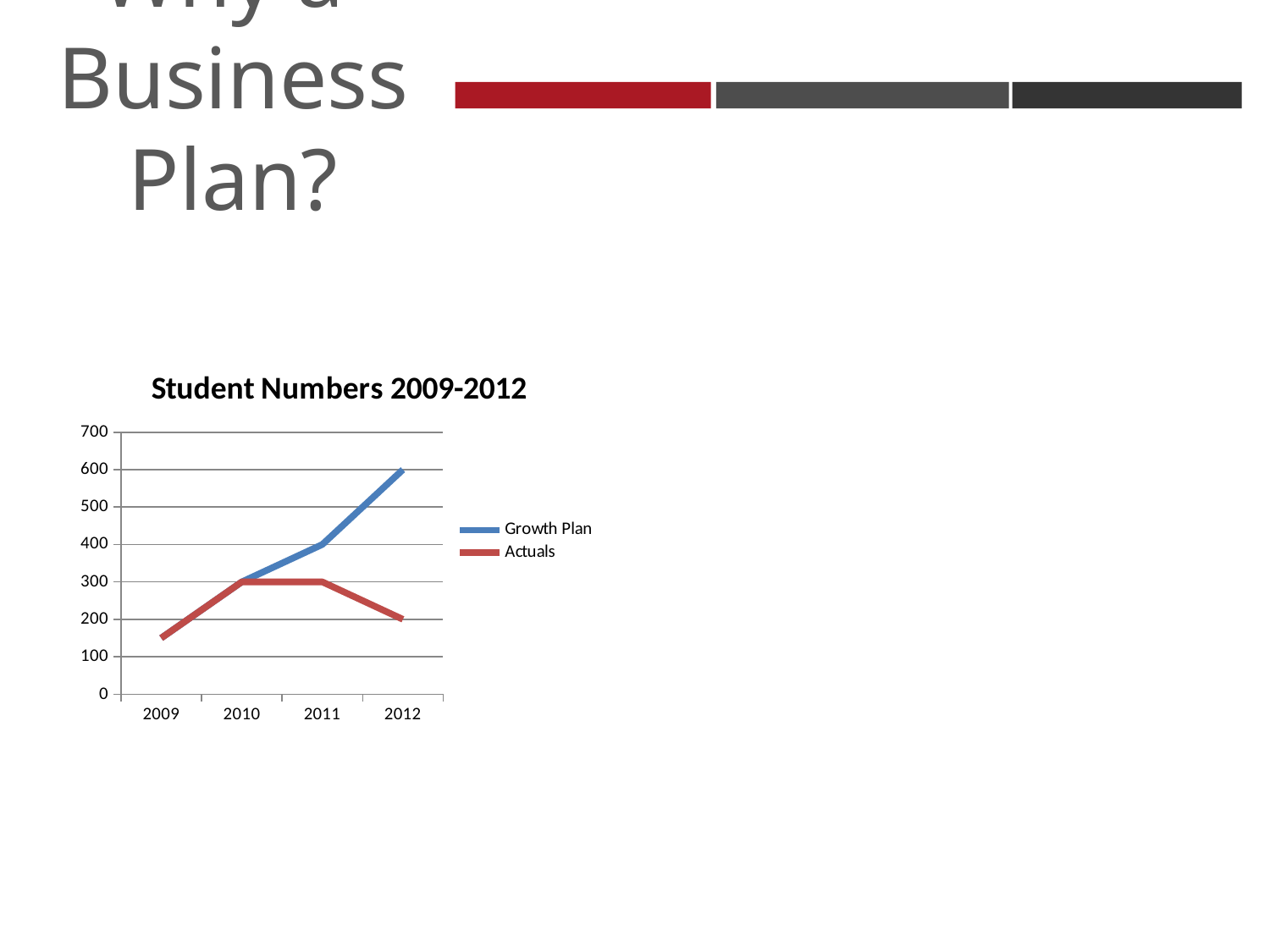
How many years are shown on the x axis? 4 What is the Growth Plan value for 2012? 600 What is the Growth Plan value for 2011? 400 In 2012, which series has the larger value, Growth Plan or Actuals? Growth Plan What is the Actuals value for 2012? 200 Is the Actuals value for 2009 greater or less than 200? less What is the Actuals value for 2010? 300 Which series is drawn in red? Actuals What type of chart is shown on the slide? line chart How many series does the legend list? 2 What is the title of the chart? Student Numbers 2009-2012 What is the difference between the Growth Plan and Actuals values in 2012? 400